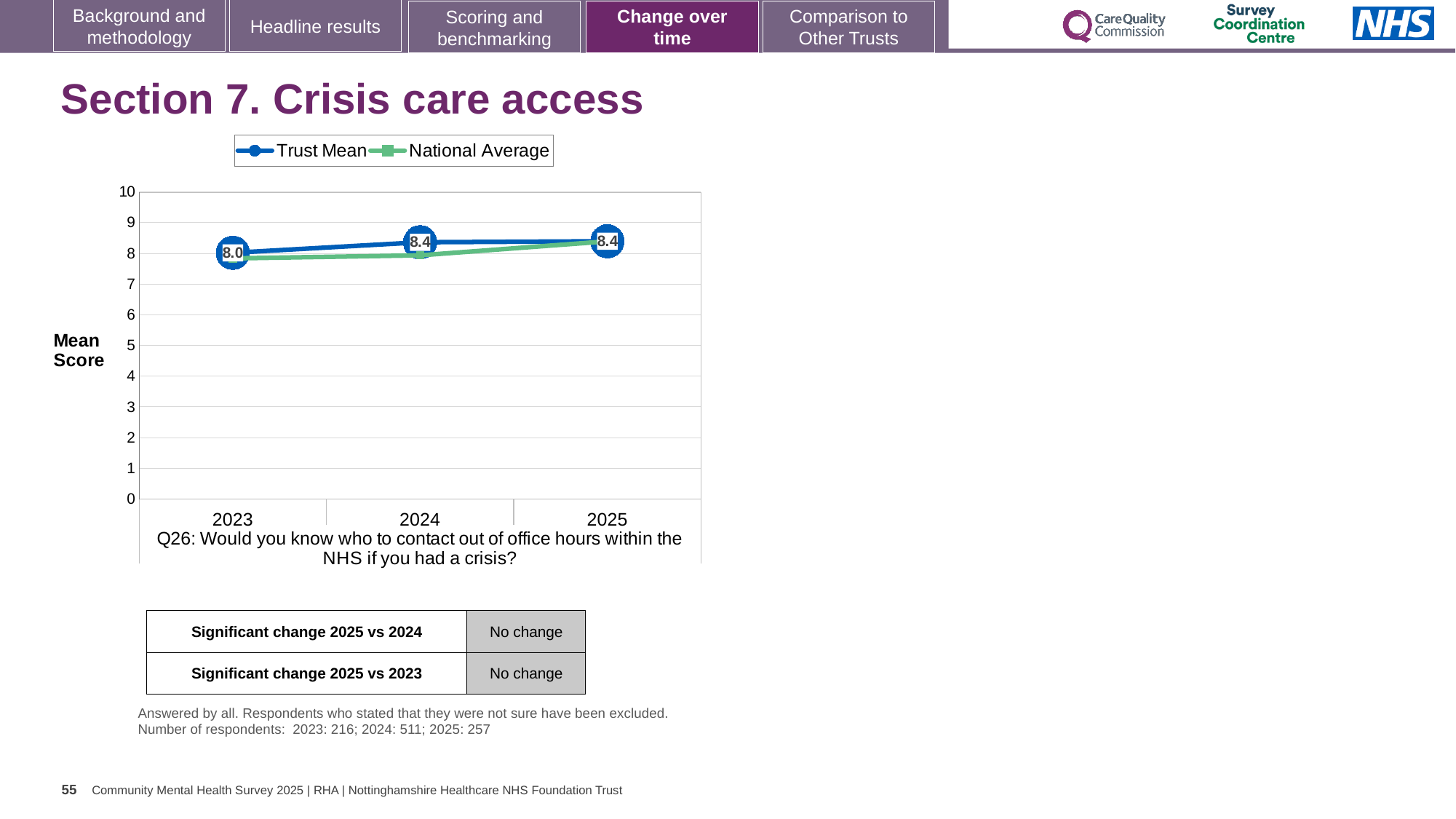
What is the Trust Mean score for 2023? 8.0 How many years are plotted on the x axis? 3 What is the difference between the Trust Mean score in 2024 and in 2023? 0.4 What is the Trust Mean score for 2024? 8.4 Is the National Average value for 2023 greater or less than 9? less Is the National Average value for 2025 greater or less than 7? greater Does the Trust Mean score rise or fall from 2023 to 2025? Rise In which year is the Trust Mean score lowest? 2023 Which is larger, the Trust Mean score for 2023 or for 2025? 2025 What kind of chart is shown on the slide? Line chart How many series does the legend list? 2 What is the Trust Mean score for 2025? 8.4